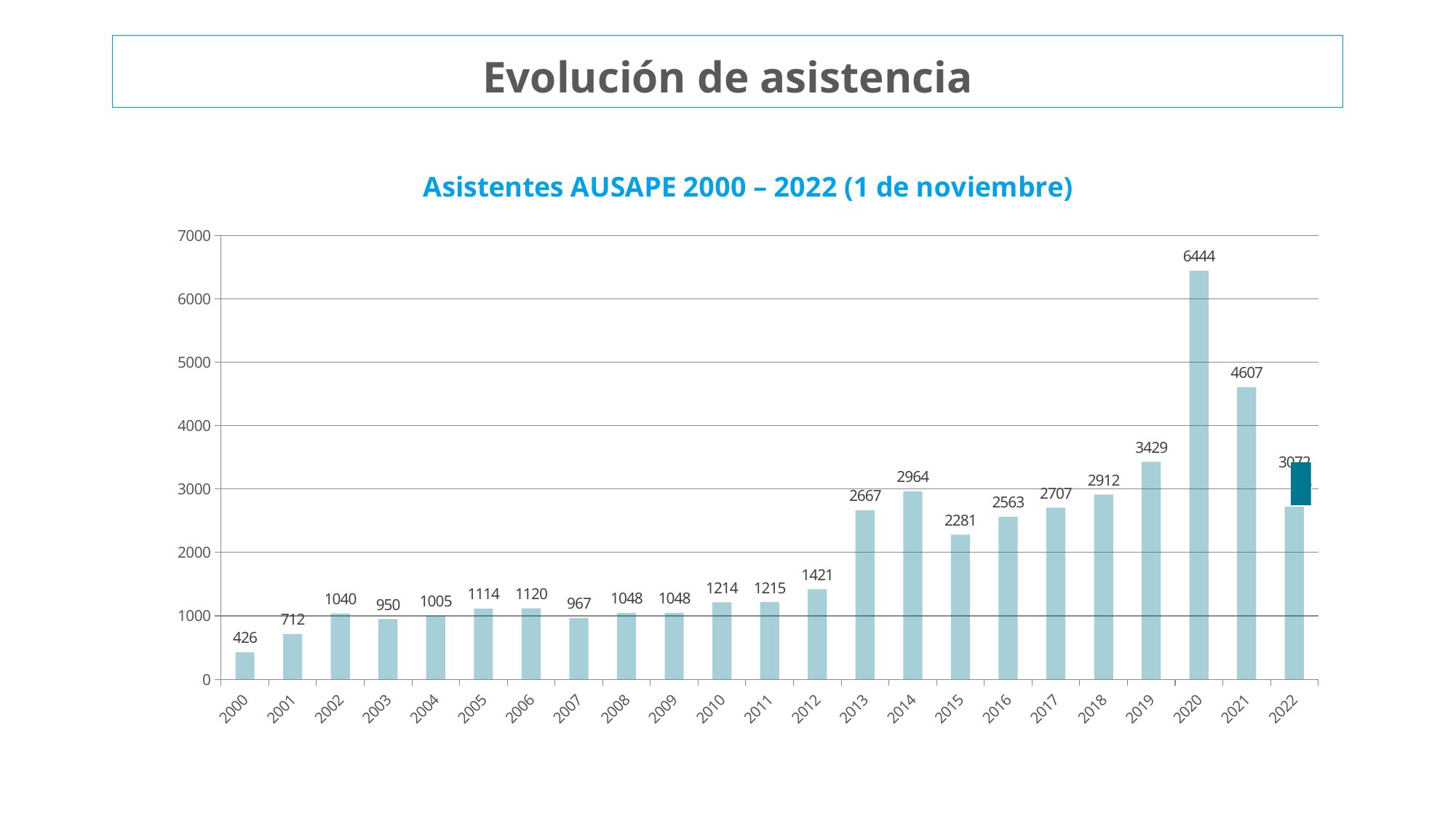
What kind of chart is this? bar chart What is the value for 2013? 2667 What is the title of the chart? Asistentes AUSAPE 2000 – 2022 (1 de noviembre) Is the value for 2019 greater or less than 3000? greater Do the values generally rise or fall from 2000 to 2020? rise What is the difference between the values for 2020 and 2021? 1837 Which year has the highest value? 2020 Which is larger, the value for 2014 or the value for 2015? 2014 What is the value for 2020? 6444 Which year has the lowest value? 2000 How many years are shown on the x axis? 23 What is the value for 2000? 426